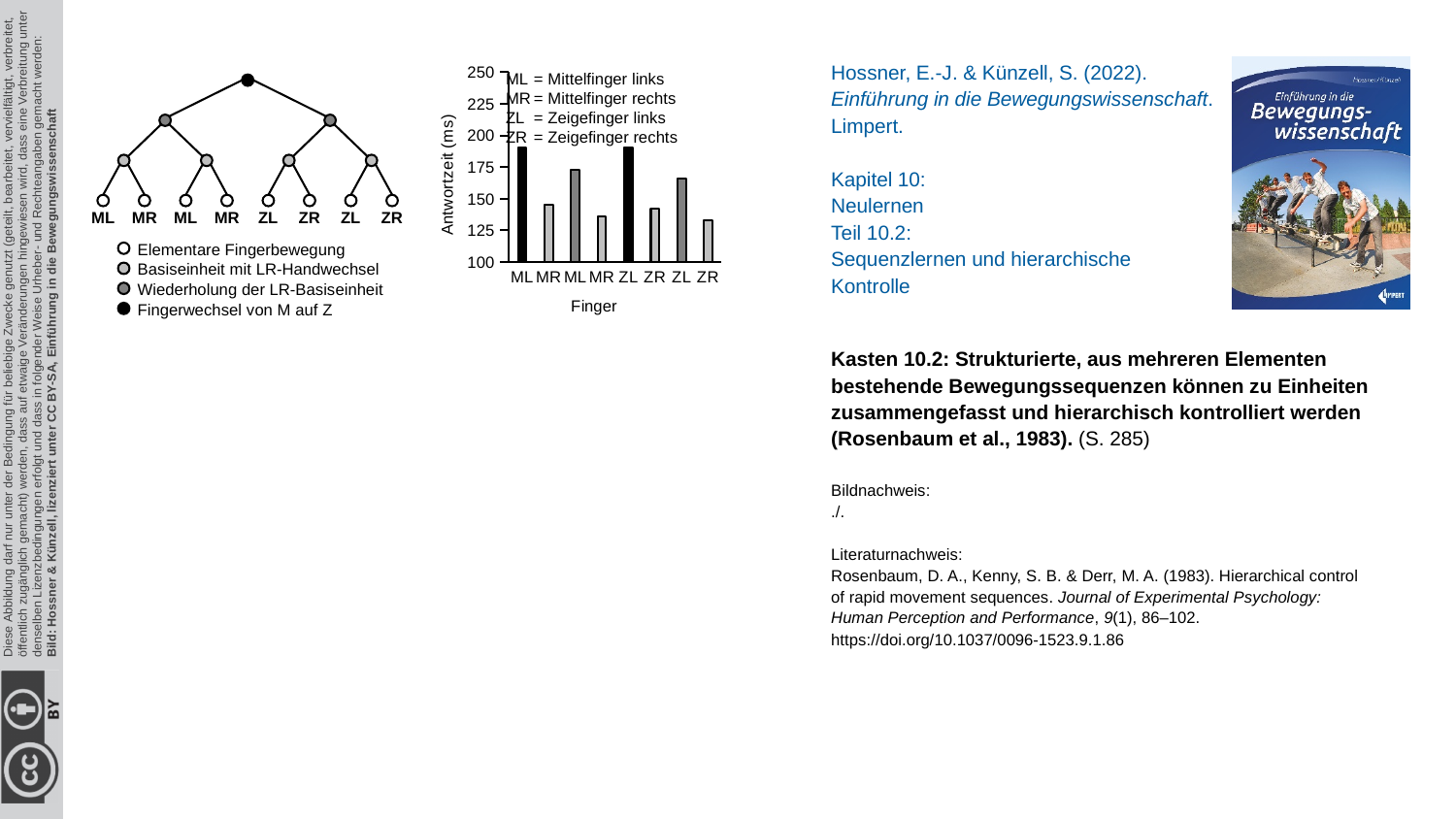
Which is larger, the second ZL bar (seventh from left) or the second ZR bar (rightmost)? the second ZL bar What is the label of the horizontal axis of the chart? Finger What kind of chart is shown on the slide? bar chart What is the label of the vertical axis of the chart? Antwortzeit (ms) Is the value for the second ML bar (third from left) greater or less than 150? greater How many bars are plotted in the chart? 8 Is the value for the second MR bar (fourth from left) greater or less than 150? less Is the value for the first MR bar (second from left) greater or less than 175? less Which is larger, the first ML bar (leftmost) or the first MR bar (second from left)? the first ML bar